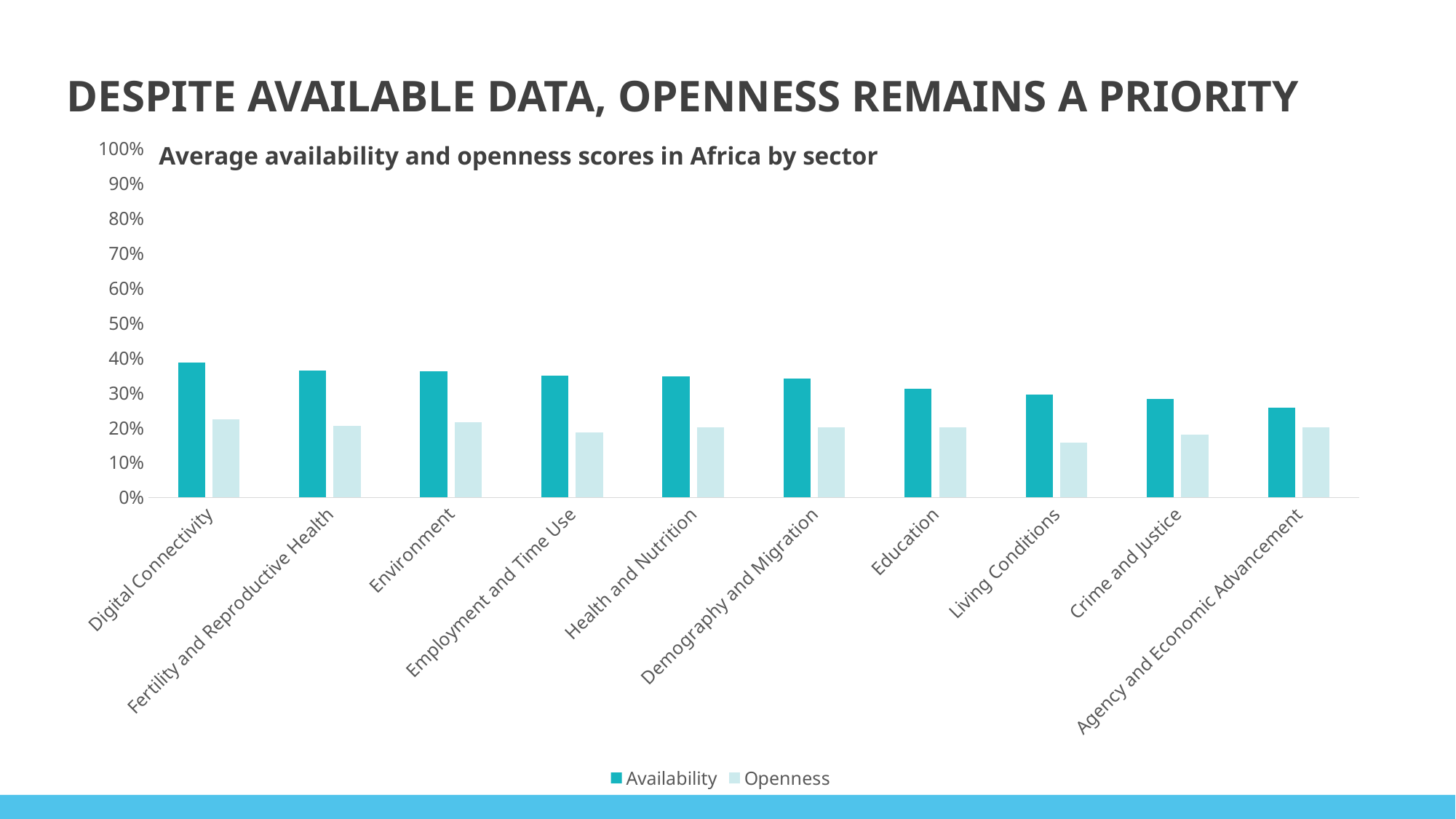
Which sector has the lowest Availability score? Agency and Economic Advancement Which sector has the lowest Openness score? Living Conditions What kind of chart is shown on the slide? Bar chart What is the title of the chart? Average availability and openness scores in Africa by sector For Environment, which is larger: the Availability score or the Openness score? Availability Which sector has the highest Availability score? Digital Connectivity How many sectors are shown on the x axis? 10 How many series does the legend list? 2 Do the Availability scores rise or fall moving from left to right along the x axis? Fall Is the Openness value for Living Conditions greater or less than 20%? less